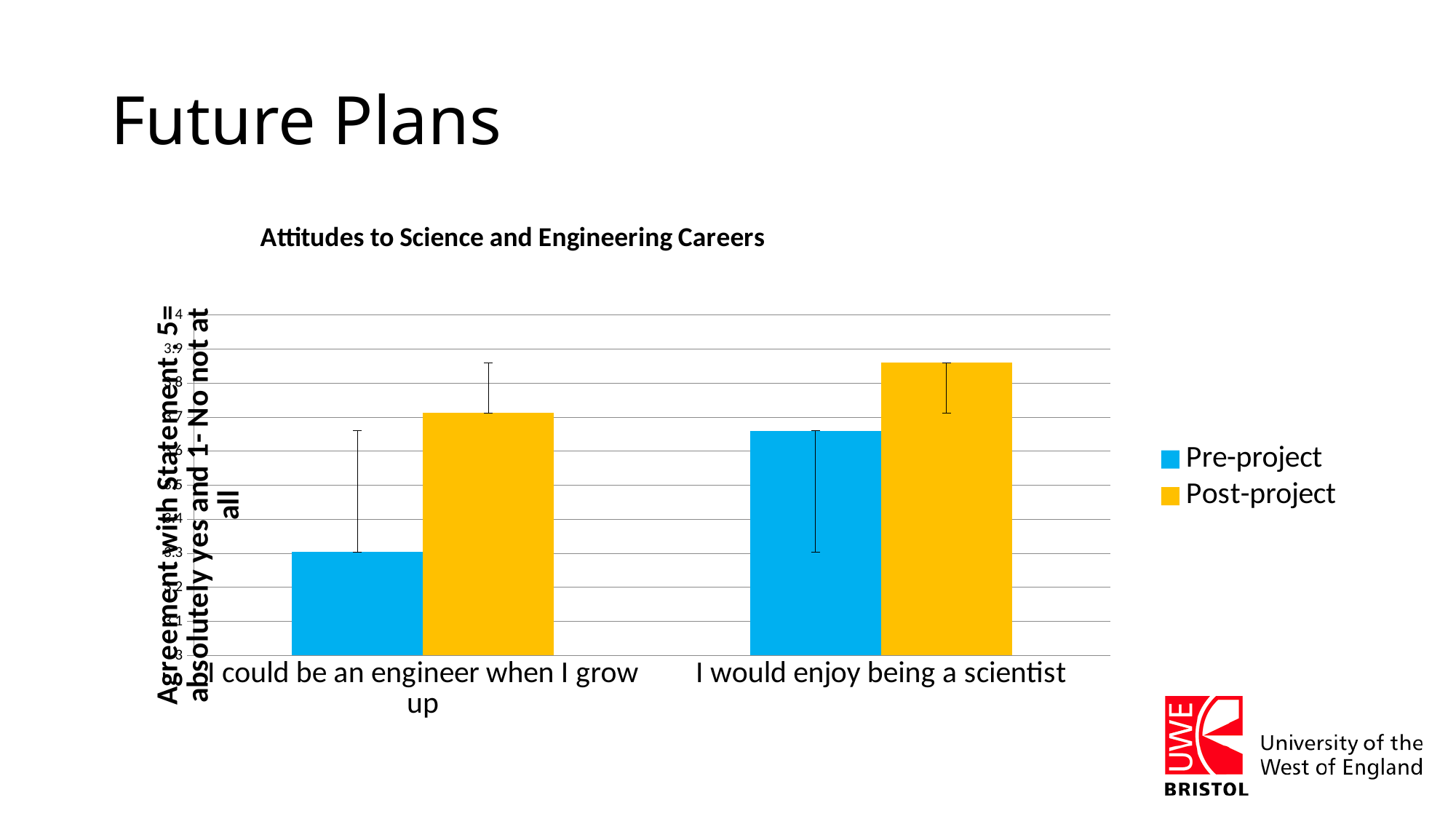
For 'I could be an engineer when I grow up', which is larger: Pre-project or Post-project? Post-project Which series is shown in yellow in the legend? Post-project Which bar is the highest on the chart? Post-project for 'I would enjoy being a scientist' Which bar is the lowest on the chart? Pre-project for 'I could be an engineer when I grow up' How many series does the legend list? 2 For 'I would enjoy being a scientist', which is larger: Pre-project or Post-project? Post-project What is the title of the chart? Attitudes to Science and Engineering Careers What kind of chart is shown on the slide? Bar chart For the Pre-project series, which category has the higher value? I would enjoy being a scientist How many categories are shown on the x axis? 2